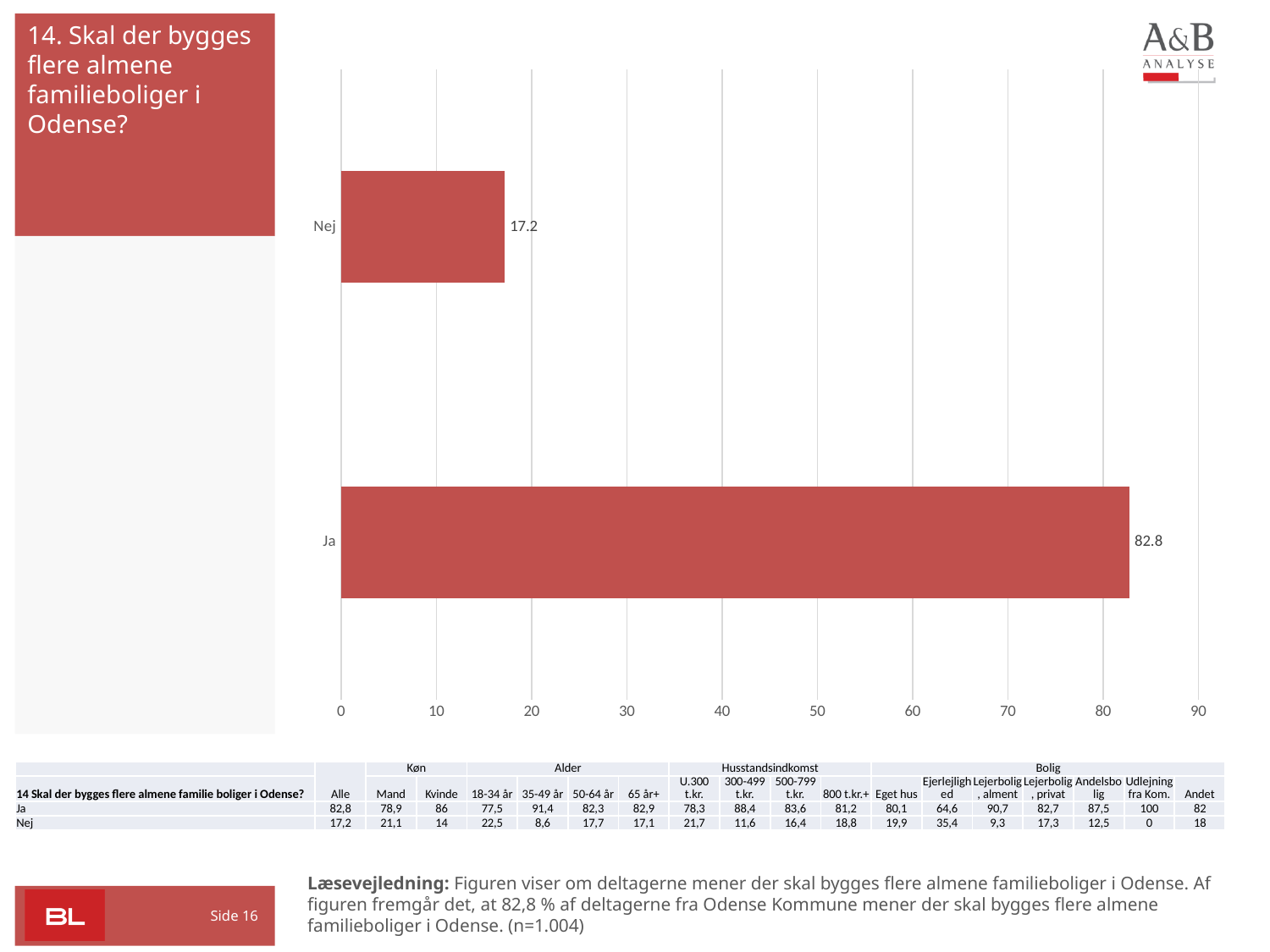
How many categories are shown in the chart? 2 Is the value for Ja greater or less than 80? greater What is the difference between the values for Ja and Nej? 65.6 Which category has the highest value? Ja What is the value for Nej? 17.2 Which category has the lowest value? Nej What kind of chart is shown on the slide? bar chart What is the highest value shown on the x axis? 90 Is the value for Nej greater or less than 20? less What is the value for Ja? 82.8 What question does the chart on the slide address? 14. Skal der bygges flere almene familieboliger i Odense? Which is larger, the value for Ja or the value for Nej? Ja